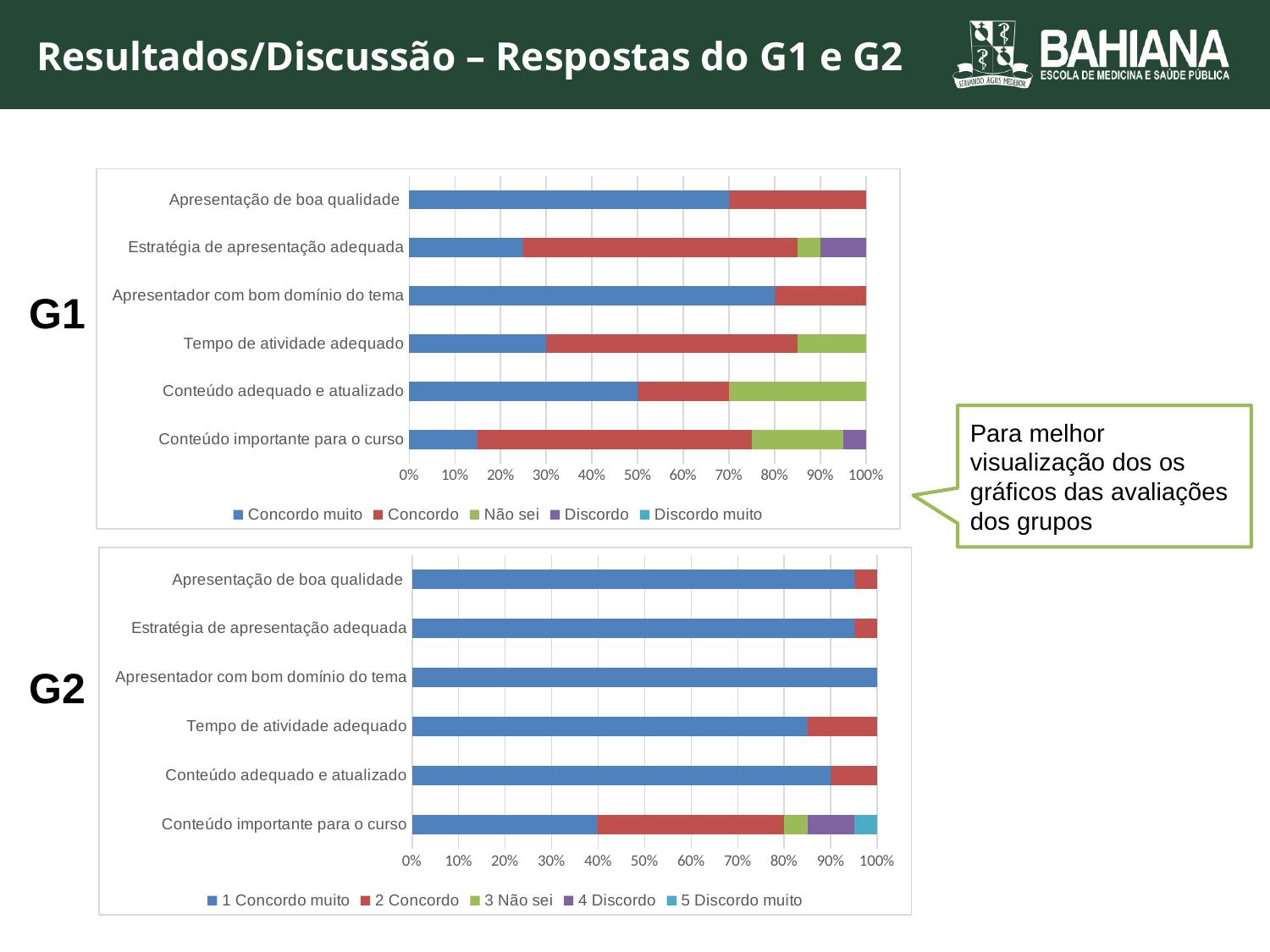
What kind of chart is the G1 chart? stacked bar chart In the G1 chart, is the 'Concordo muito' value for 'Conteúdo importante para o curso' greater or less than 20%? less In the G1 chart, which category has the highest 'Concordo muito' share? Apresentador com bom domínio do tema In the G2 chart, which category is the only one with a 'Discordo muito' segment? Conteúdo importante para o curso In the G1 chart, which has the larger 'Concordo muito' share: 'Apresentação de boa qualidade' or 'Estratégia de apresentação adequada'? Apresentação de boa qualidade How many series does the legend of the G1 chart list? 5 How many categories are shown on the G2 chart? 6 In the G2 chart, which category has the lowest 'Concordo muito' share? Conteúdo importante para o curso In the G1 chart, is the 'Concordo muito' value for 'Apresentação de boa qualidade' greater or less than 60%? greater In the G2 chart, is the 'Concordo muito' value for 'Conteúdo importante para o curso' greater or less than 50%? less